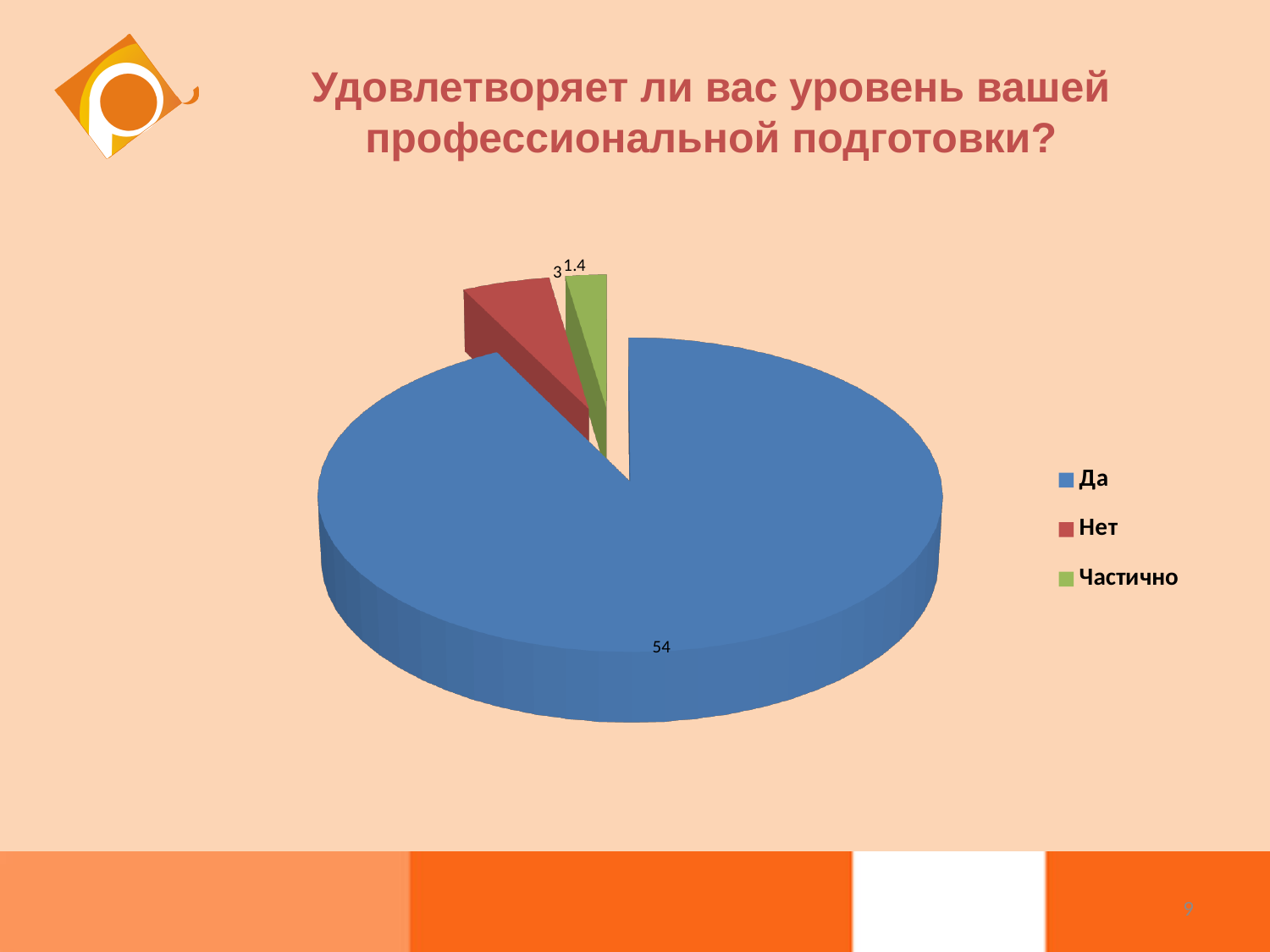
What is the value for the "Да" slice? 54 How many slices does the pie chart have? 3 What is the difference between the values for "Нет" and "Частично"? 1.6 What type of chart is shown on the slide? Pie chart What is the difference between the values for "Да" and "Нет"? 51 What colour is the "Да" slice? Blue How many entries does the legend list? 3 Which is larger, the value for "Нет" or the value for "Частично"? Нет What is the value for the "Нет" slice? 3 What is the value for the "Частично" slice? 1.4 Which category has the largest slice? Да Which category has the smallest slice? Частично